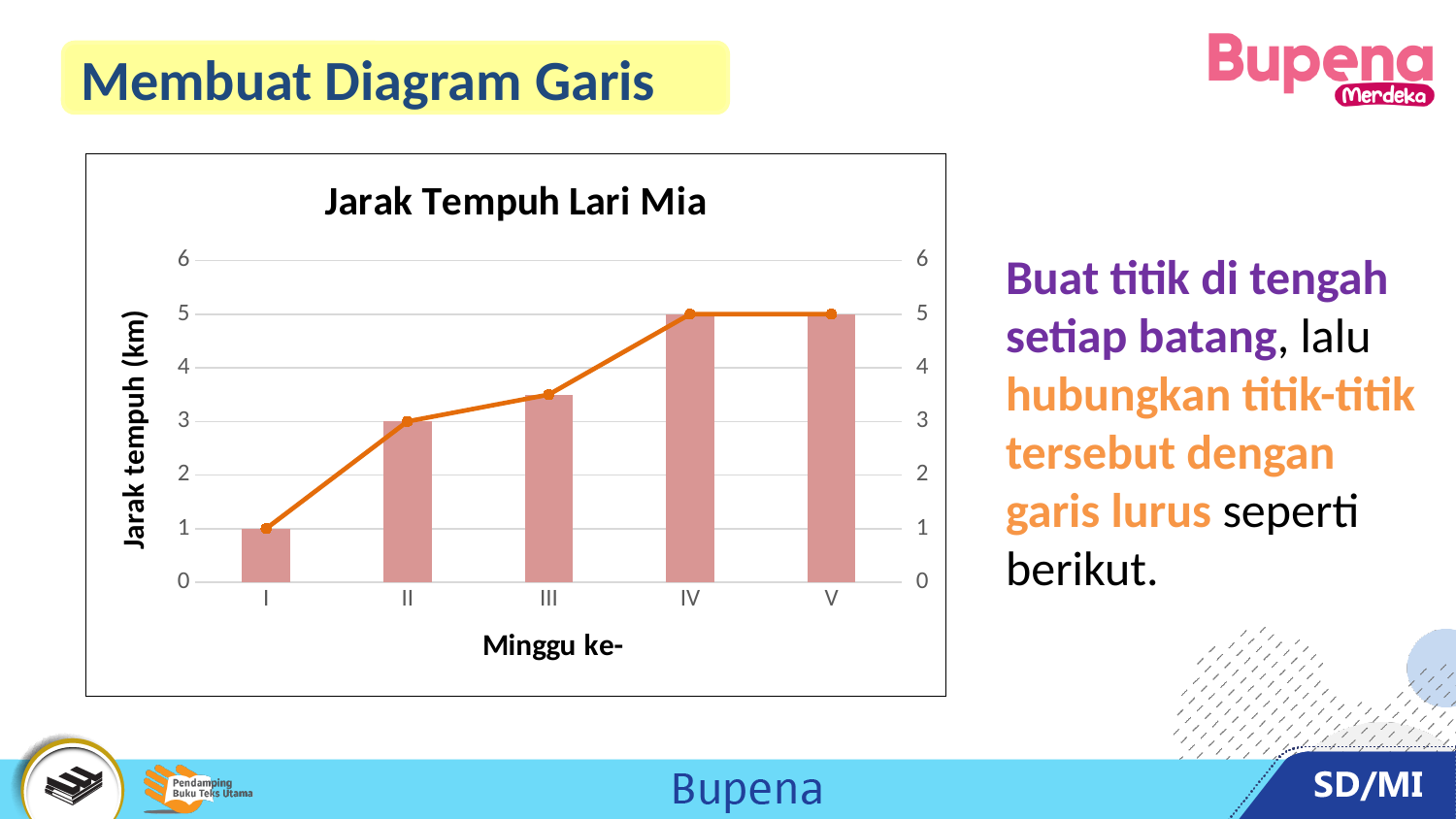
Do the values generally rise or fall from Minggu ke- I to Minggu ke- V? rise Is the value for Minggu ke- III greater or less than 4? less What is the value for Minggu ke- I in the Jarak Tempuh Lari Mia chart? 1 How many weeks (categories) are shown on the x axis of the chart? 5 What is the label of the vertical axis of the chart? Jarak tempuh (km) Is the value for Minggu ke- III greater or less than 3? greater Which is larger, the value for Minggu ke- II or Minggu ke- IV? IV What is the difference between the values for Minggu ke- IV and Minggu ke- I? 4 What is the title of the chart on the slide? Jarak Tempuh Lari Mia What is the value for Minggu ke- IV in the Jarak Tempuh Lari Mia chart? 5 What is the value for Minggu ke- II in the Jarak Tempuh Lari Mia chart? 3 Which week has the lowest jarak tempuh in the chart? I